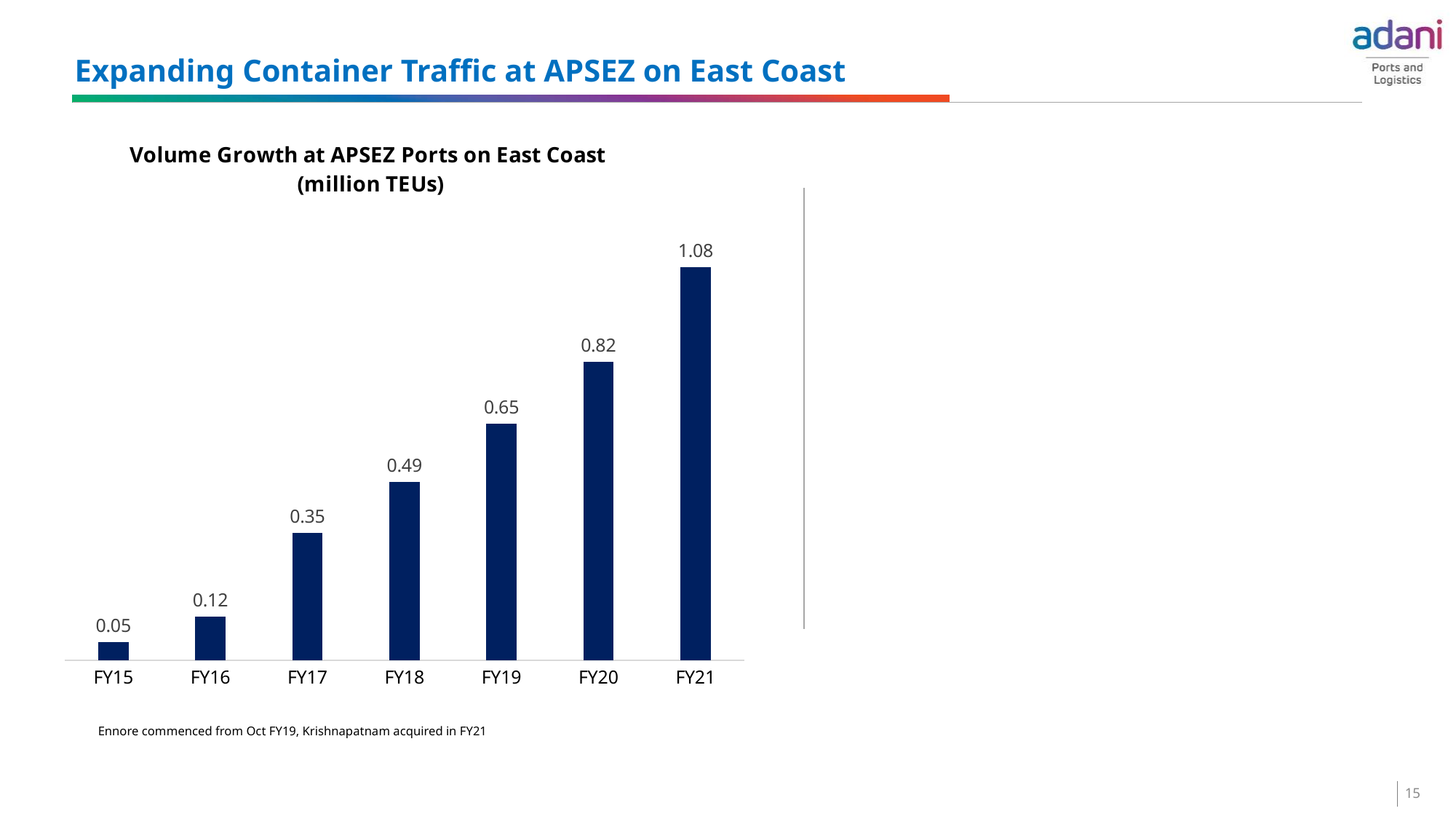
What unit is given in the chart title? million TEUs Do the values rise or fall from FY15 to FY21? Rise What is the value for FY18? 0.49 Which year has the lowest value? FY15 What kind of chart is shown? Bar chart What is the difference between the values for FY21 and FY20? 0.26 What is the difference between the values for FY19 and FY17? 0.30 Which is larger, the value for FY17 or the value for FY18? FY18 What is the value for FY21? 1.08 What is the value for FY15? 0.05 How many years are shown on the x axis? 7 Which year has the highest value? FY21